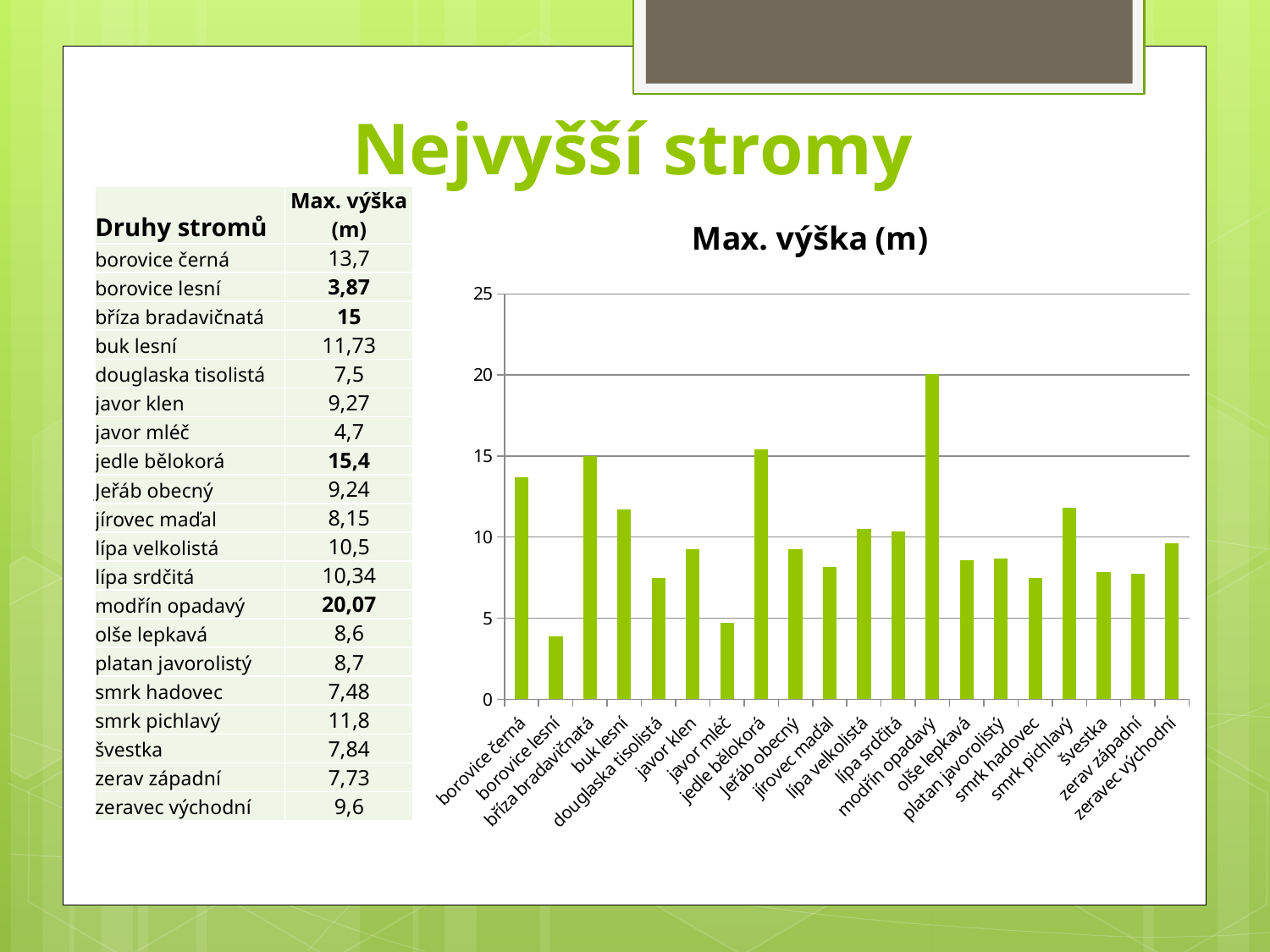
Is the value for bříza bradavičnatá greater or less than 10? greater What is the maximum height shown for borovice lesní? 3,87 What is the difference between the maximum heights of modřín opadavý and borovice lesní? 16,2 What is the maximum height shown for jedle bělokorá? 15,4 Is the value for javor mléč greater or less than 5? less Which tree species has the lowest maximum height in the chart? borovice lesní What type of chart is shown on the slide? bar chart Which tree species has the highest maximum height in the chart? modřín opadavý What is the maximum height shown for modřín opadavý? 20,07 Which is taller, buk lesní or douglaska tisolistá? buk lesní What is the title of the chart? Max. výška (m) How many tree species (categories) are plotted in the chart? 20